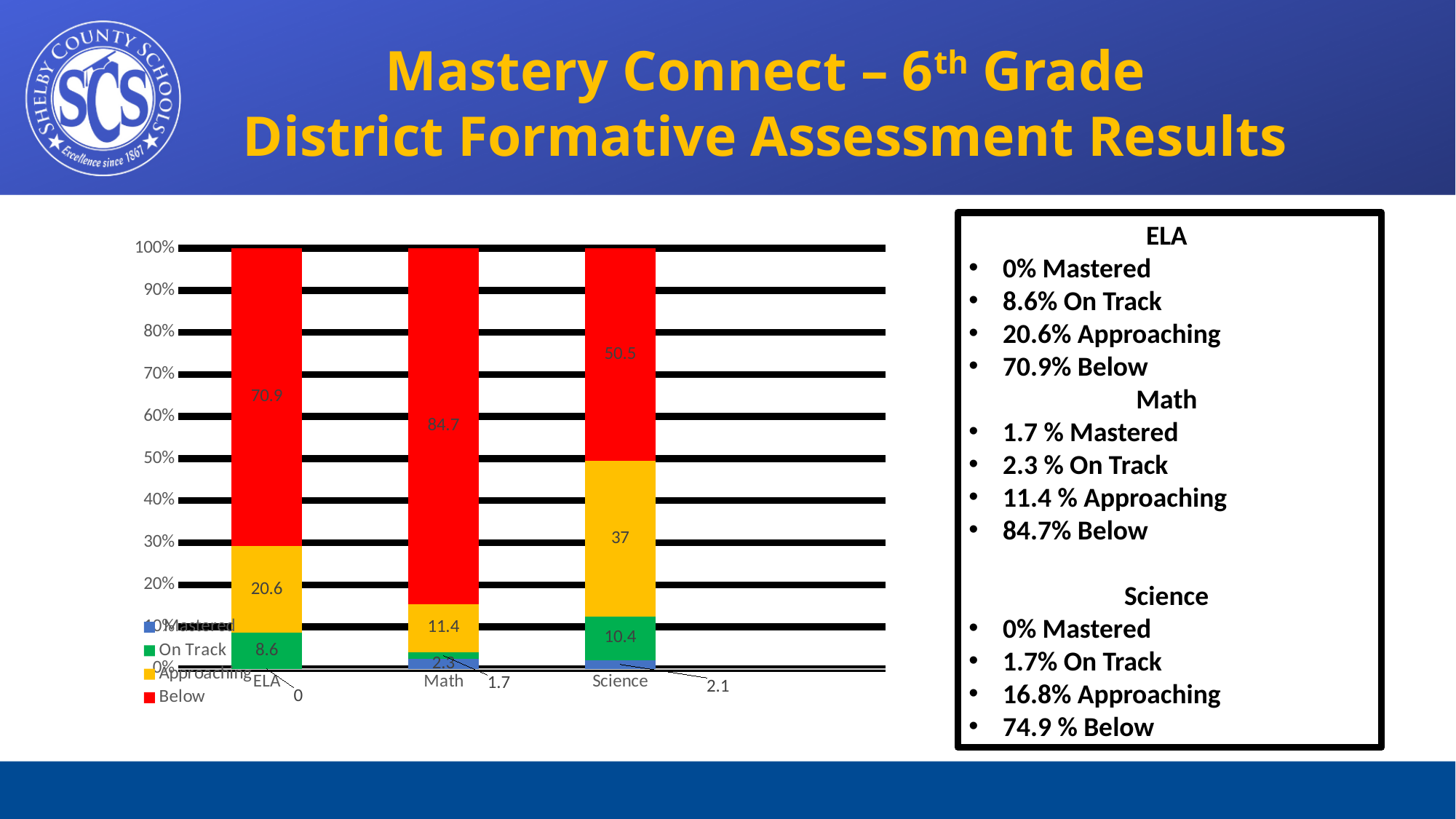
Which colour represents the Below series in the chart? Red What is the Approaching value for Science? 37 Which category has the lowest Approaching value? Math What is the difference between the Below values for Math and ELA? 13.8 What is the On Track value for ELA? 8.6 Which is larger, the On Track value for Science or the On Track value for Math? Science What kind of chart is shown on the slide? Stacked bar chart What is the Below value for Math? 84.7 Which category has the highest Below value? Math How many categories are shown on the x axis? 3 How many series does the legend list? 4